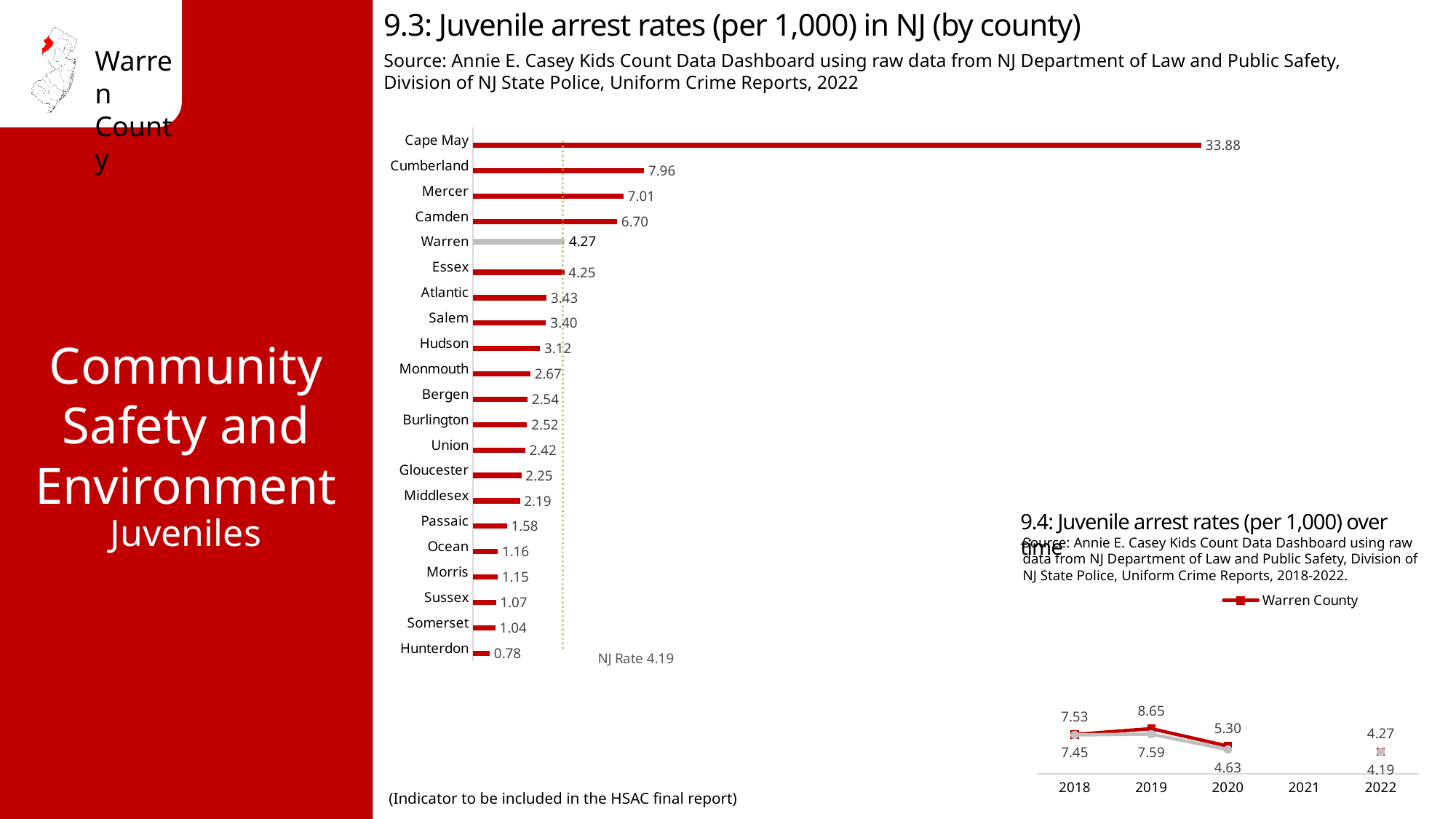
In the chart '9.4: Juvenile arrest rates (per 1,000) over time', what is the difference between the Warren County values for 2019 and 2020? 3.35 What kind of chart is '9.3: Juvenile arrest rates (per 1,000) in NJ (by county)'? Bar chart In the chart '9.3: Juvenile arrest rates (per 1,000) in NJ (by county)', which has a higher value, Camden or Essex? Camden In the chart '9.3: Juvenile arrest rates (per 1,000) in NJ (by county)', what NJ rate is marked by the dotted reference line? 4.19 In the chart '9.3: Juvenile arrest rates (per 1,000) in NJ (by county)', which county has the highest juvenile arrest rate? Cape May In the chart '9.3: Juvenile arrest rates (per 1,000) in NJ (by county)', which county has the lowest juvenile arrest rate? Hunterdon In the chart '9.4: Juvenile arrest rates (per 1,000) over time', what is the Warren County value for 2019? 8.65 In the chart '9.3: Juvenile arrest rates (per 1,000) in NJ (by county)', what is the value for Warren? 4.27 In the chart '9.3: Juvenile arrest rates (per 1,000) in NJ (by county)', what is the value for Cape May? 33.88 In the chart '9.3: Juvenile arrest rates (per 1,000) in NJ (by county)', how many counties are shown? 21 In the chart '9.3: Juvenile arrest rates (per 1,000) in NJ (by county)', what is the difference between the values for Cumberland and Mercer? 0.95 In the chart '9.4: Juvenile arrest rates (per 1,000) over time', what is the Warren County value for 2022? 4.27